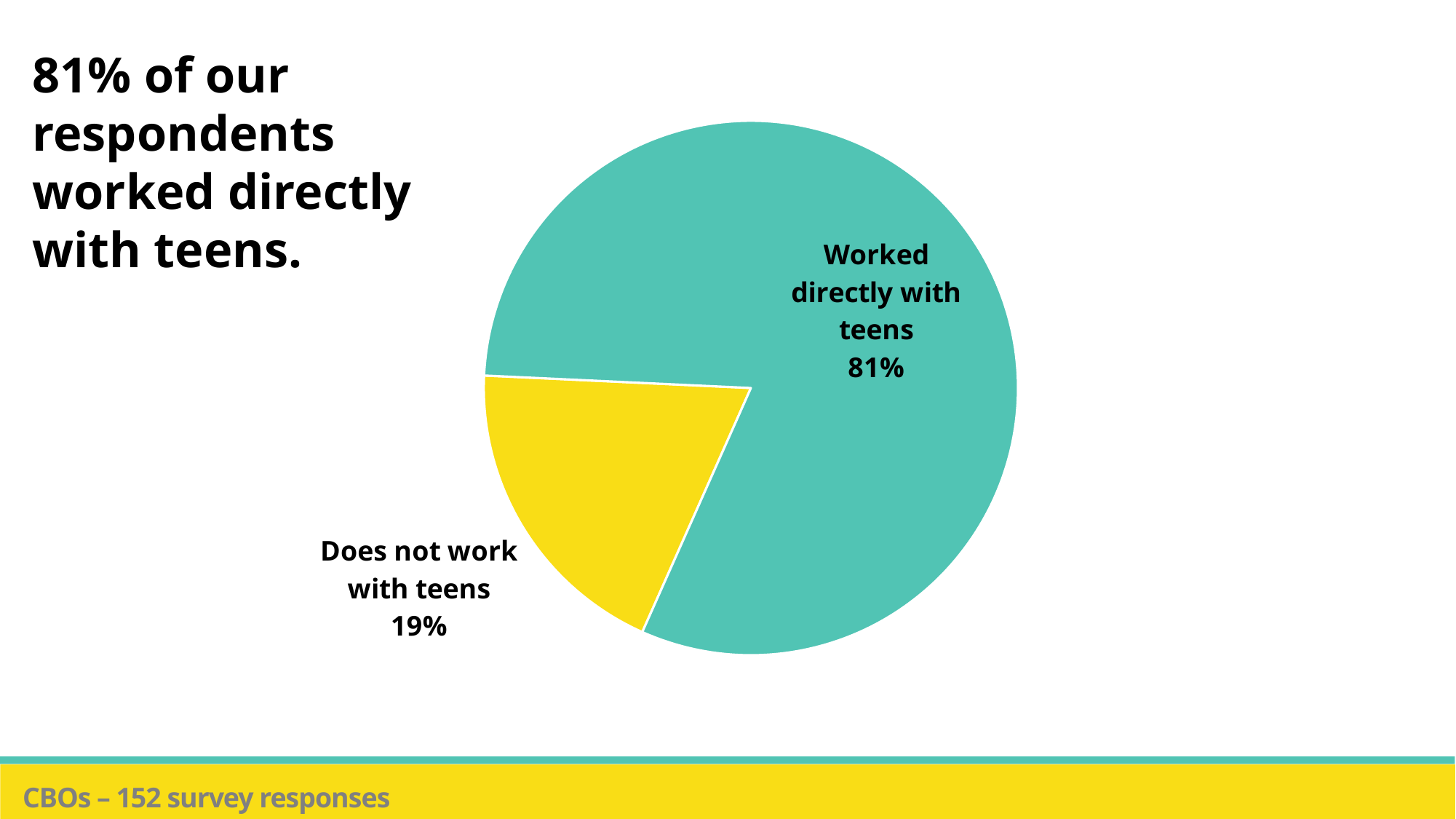
What colour is the 'Does not work with teens' slice? yellow What kind of chart is shown on the slide? pie chart What is the difference in percentage points between the 'Worked directly with teens' slice and the 'Does not work with teens' slice? 62 What share of respondents worked directly with teens? 81% How many survey responses does the footer say the chart is based on? 152 Which slice of the pie is the smallest? Does not work with teens Which slice of the pie is the largest? Worked directly with teens Which is larger: the share that worked directly with teens or the share that does not work with teens? Worked directly with teens How many slices does the pie chart have? 2 What share of respondents does not work with teens? 19%